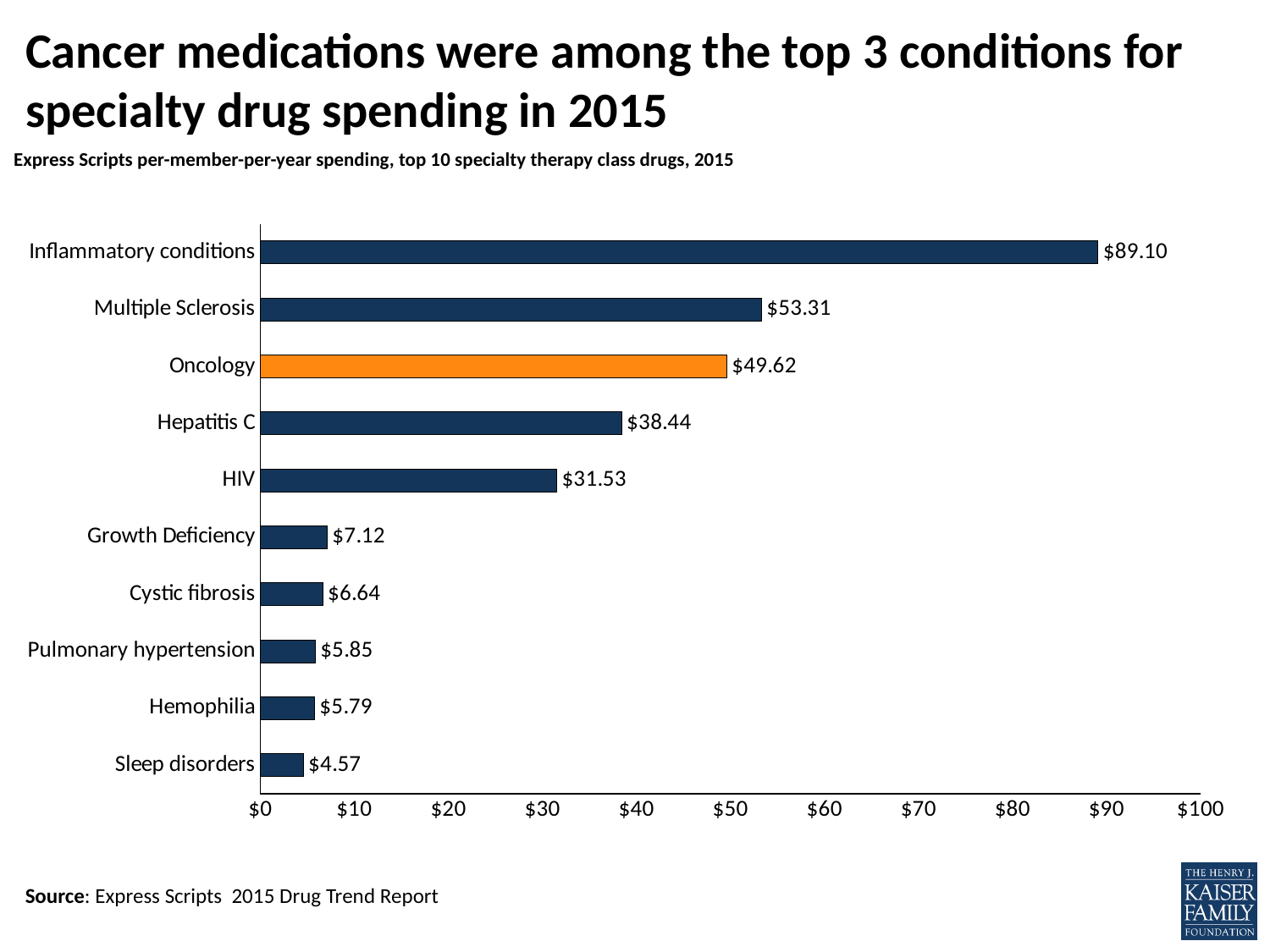
How many therapy classes are shown in the chart? 10 What is the per-member-per-year spending for Hepatitis C? $38.44 Is the value for HIV greater or less than $40? less Which therapy class has the lowest spending? Sleep disorders What is the difference between the spending for Inflammatory conditions and Multiple Sclerosis? $35.79 Which therapy class has the highest spending? Inflammatory conditions Which bar is highlighted in orange? Oncology What kind of chart is shown on the slide? Bar chart What is the per-member-per-year spending for Oncology? $49.62 What is the difference between the spending for Oncology and HIV? $18.09 What is the value shown for Hemophilia? $5.79 Which has higher spending, Growth Deficiency or Cystic fibrosis? Growth Deficiency